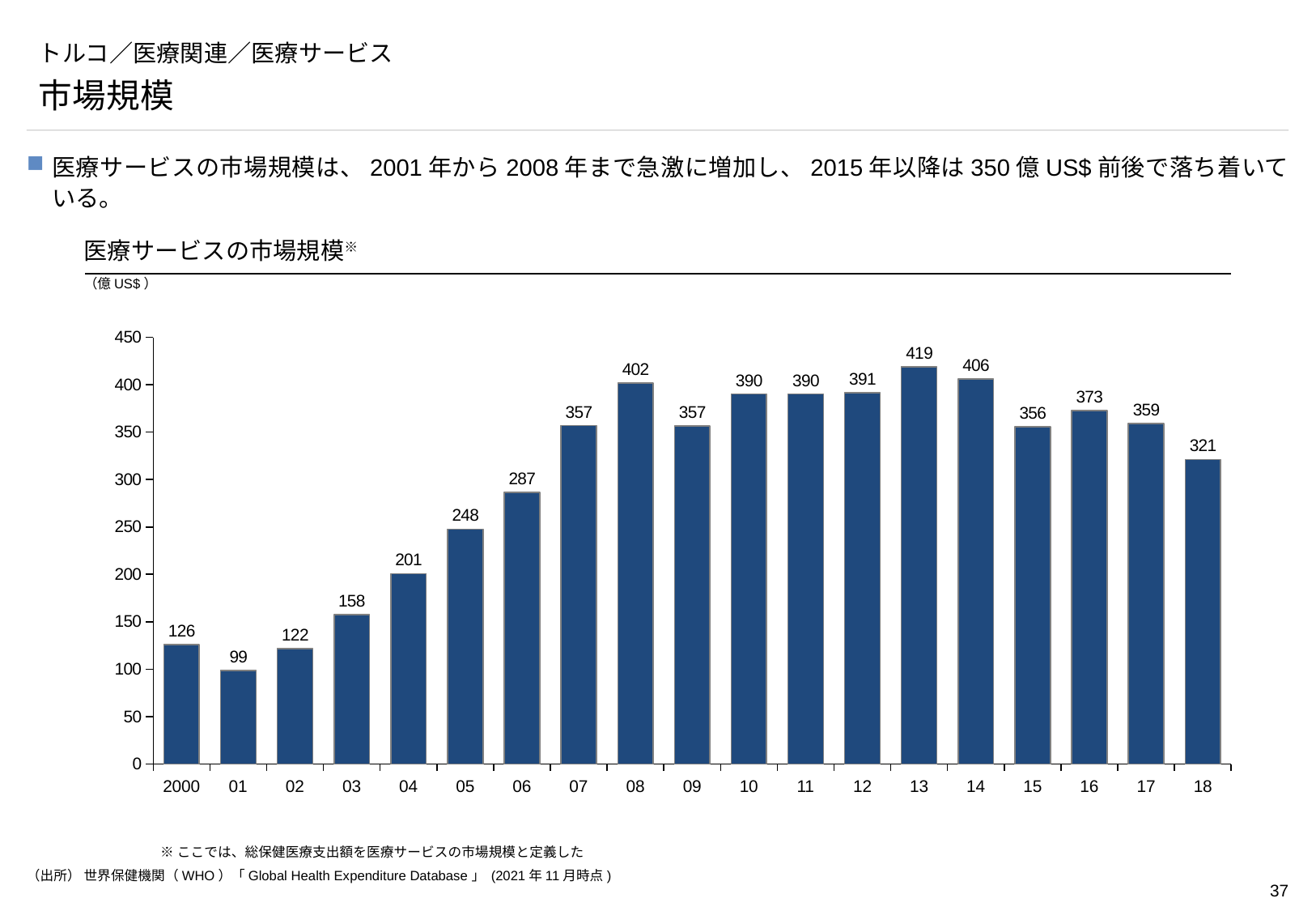
Which is larger, the value for 2016 or the value for 2017? 2016 What is the value for 2018? 321 What is the value for 2004? 201 What is the difference between the values for 2013 and 2018? 98 What kind of chart is shown? bar chart What is the value for 2008? 402 Is the value for 2006 greater or less than 300? less Which year has the highest value? 13 How many years are shown on the x axis? 19 What is the unit shown for the y axis? 億US$ Which year has the lowest value? 01 Do the values rise or fall from 2001 to 2008? rise